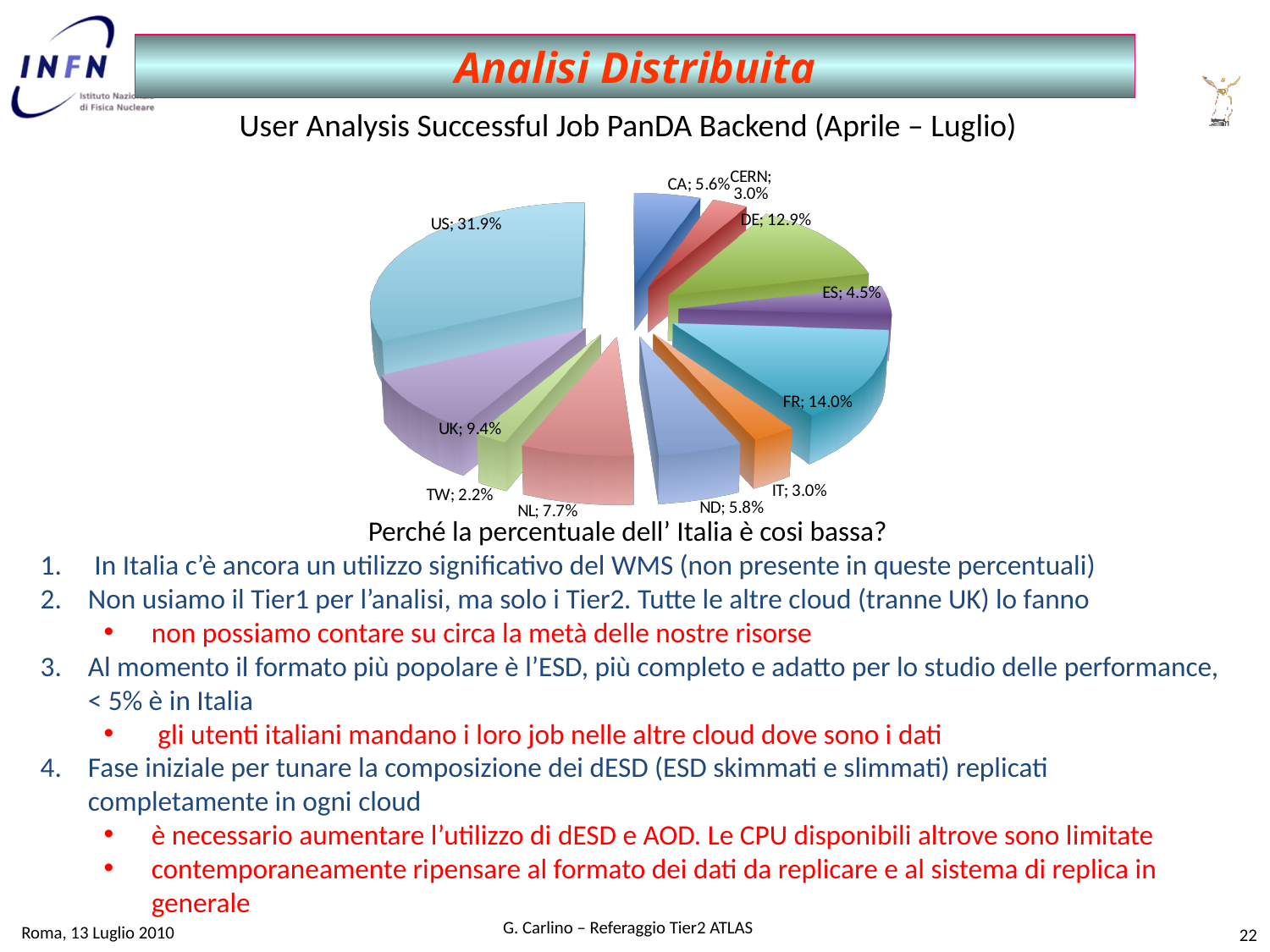
What percentage of successful user analysis jobs is attributed to the US? 31.9% Which has a larger share, UK or NL? UK What percentage is shown for FR? 14.0% Which cloud has the largest share of the pie? US What type of chart is shown on the slide? pie chart How many slices does the pie chart have? 11 Which cloud has the smallest share of the pie? TW What is the title shown above the pie chart? User Analysis Successful Job PanDA Backend (Aprile – Luglio) What is the difference between the FR share and the IT share? 11.0% What percentage is shown for DE? 12.9% What is the difference between the US share and the DE share? 19.0% What percentage is shown for IT in the pie chart? 3.0%